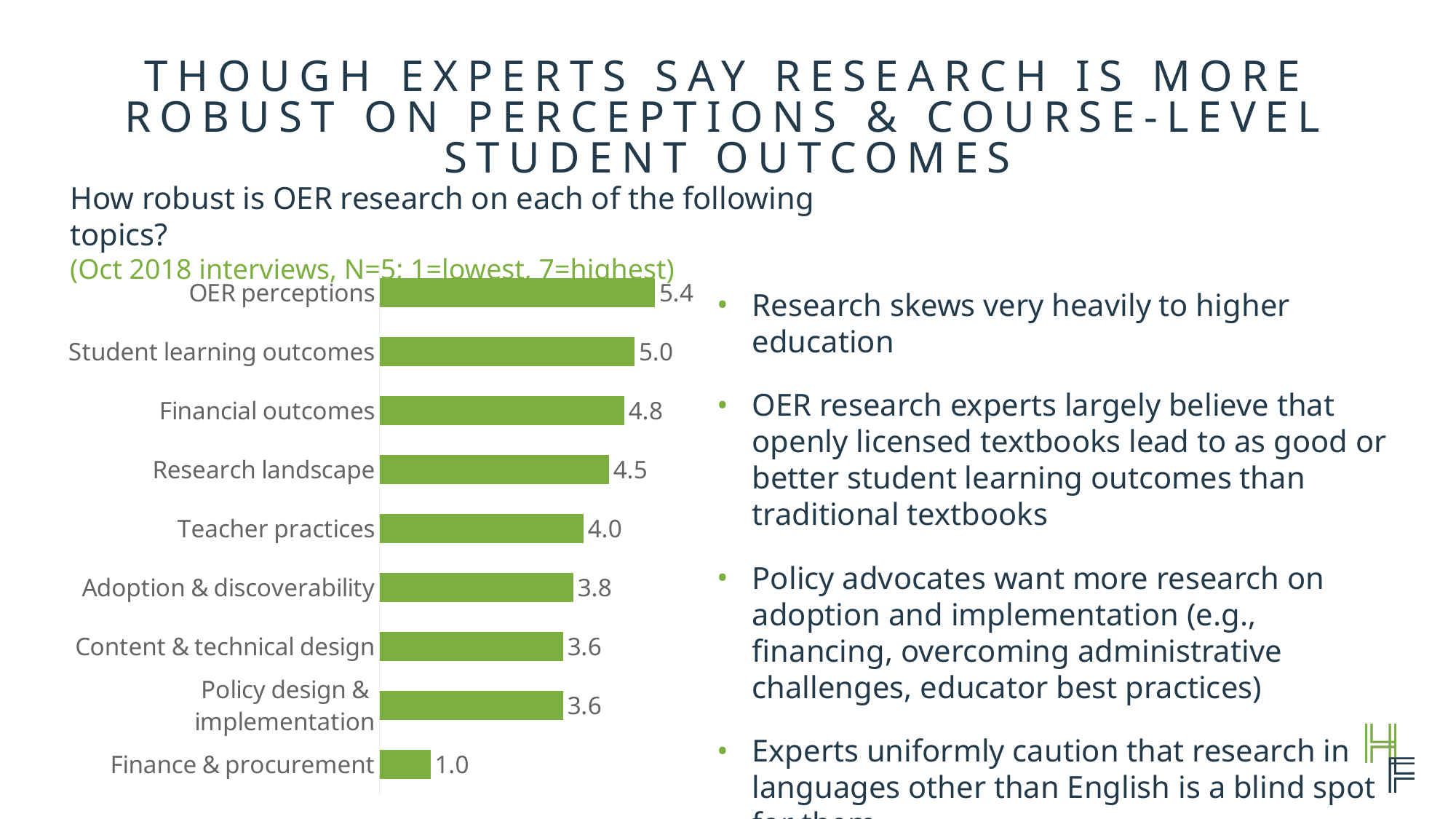
What colour are the bars in the chart? Green Which topic has the lowest value? Finance & procurement How many topics are shown in the chart? 9 What is the value for Teacher practices? 4.0 What kind of chart is shown on the slide? Bar chart What is the value for OER perceptions? 5.4 What is the difference between the values for Research landscape and Finance & procurement? 3.5 What is the value for Finance & procurement? 1.0 What is the difference between the values for OER perceptions and Student learning outcomes? 0.4 Which topic has the highest value? OER perceptions Which is larger, the value for Financial outcomes or the value for Adoption & discoverability? Financial outcomes What is the value for Content & technical design? 3.6